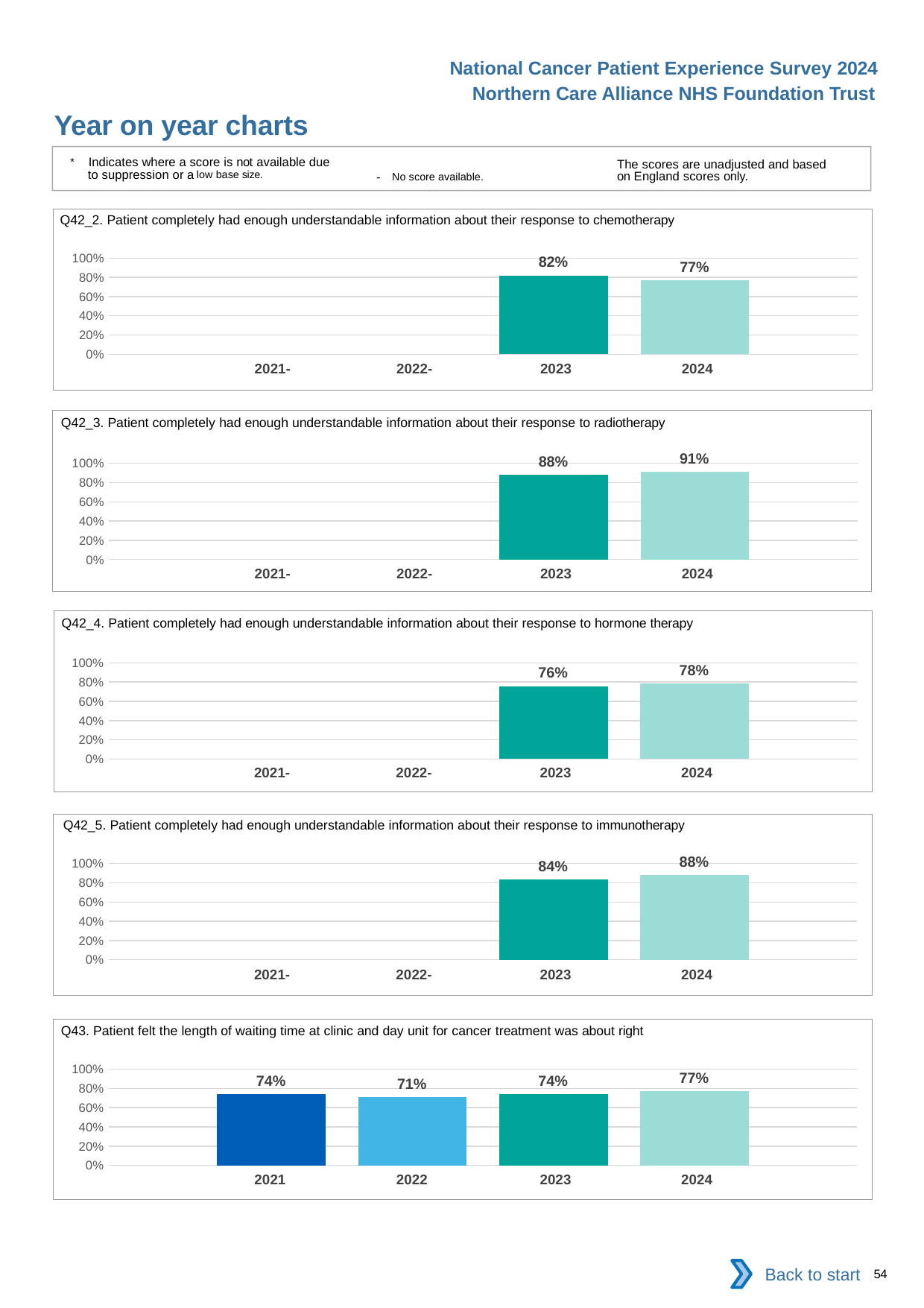
In the Q42_3 chart (radiotherapy), what is the value for 2024? 91% In the Q43 chart (waiting time at clinic and day unit), which year has the highest value? 2024 In the Q42_4 chart (hormone therapy), what is the value for 2023? 76% In the Q42_3 chart (radiotherapy), which year has the higher value, 2023 or 2024? 2024 In the Q42_2 chart (chemotherapy), what is the value for 2023? 82% In the Q42_5 chart (immunotherapy), what is the value for 2024? 88% In the Q43 chart (waiting time at clinic and day unit), how many years have bars plotted? 4 In the Q42_2 chart (chemotherapy), what is the difference between the 2023 and 2024 values? 5% In the Q43 chart (waiting time at clinic and day unit), which year has the lowest value? 2022 In the Q42_5 chart (immunotherapy), what is the difference between the 2024 and 2023 values? 4% In the Q42_4 chart (hormone therapy), is the value for 2024 greater or less than 60%? greater What type of chart is the Q43 chart at the bottom of the slide? Bar chart